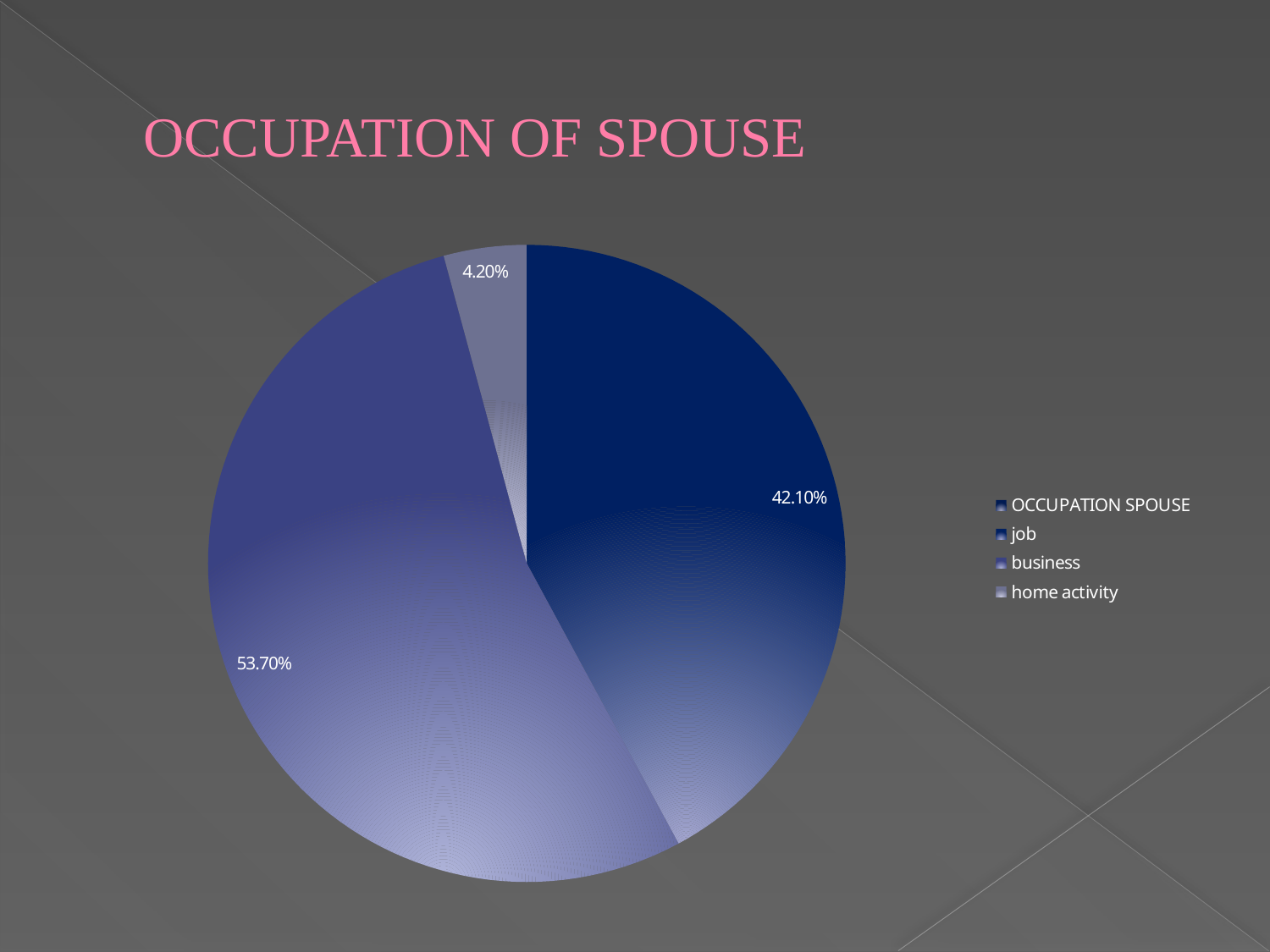
What is the difference between the largest slice (53.70%) and the second-largest slice (42.10%)? 11.60% What kind of chart is shown on the slide? pie chart What is the title of the chart? OCCUPATION OF SPOUSE How many entries does the legend list? 4 What do the three labeled slice percentages add up to? 100% How many labeled slices does the pie chart have? 3 What is the percentage shown on the smallest slice of the pie? 4.20% Is the largest slice of the pie greater or less than 50%? greater Which is larger, the slice labeled 42.10% or the slice labeled 53.70%? 53.70% What is the last entry listed in the legend? home activity What is the difference between the 42.10% slice and the 4.20% slice? 37.90% What is the percentage shown on the largest slice of the pie? 53.70%